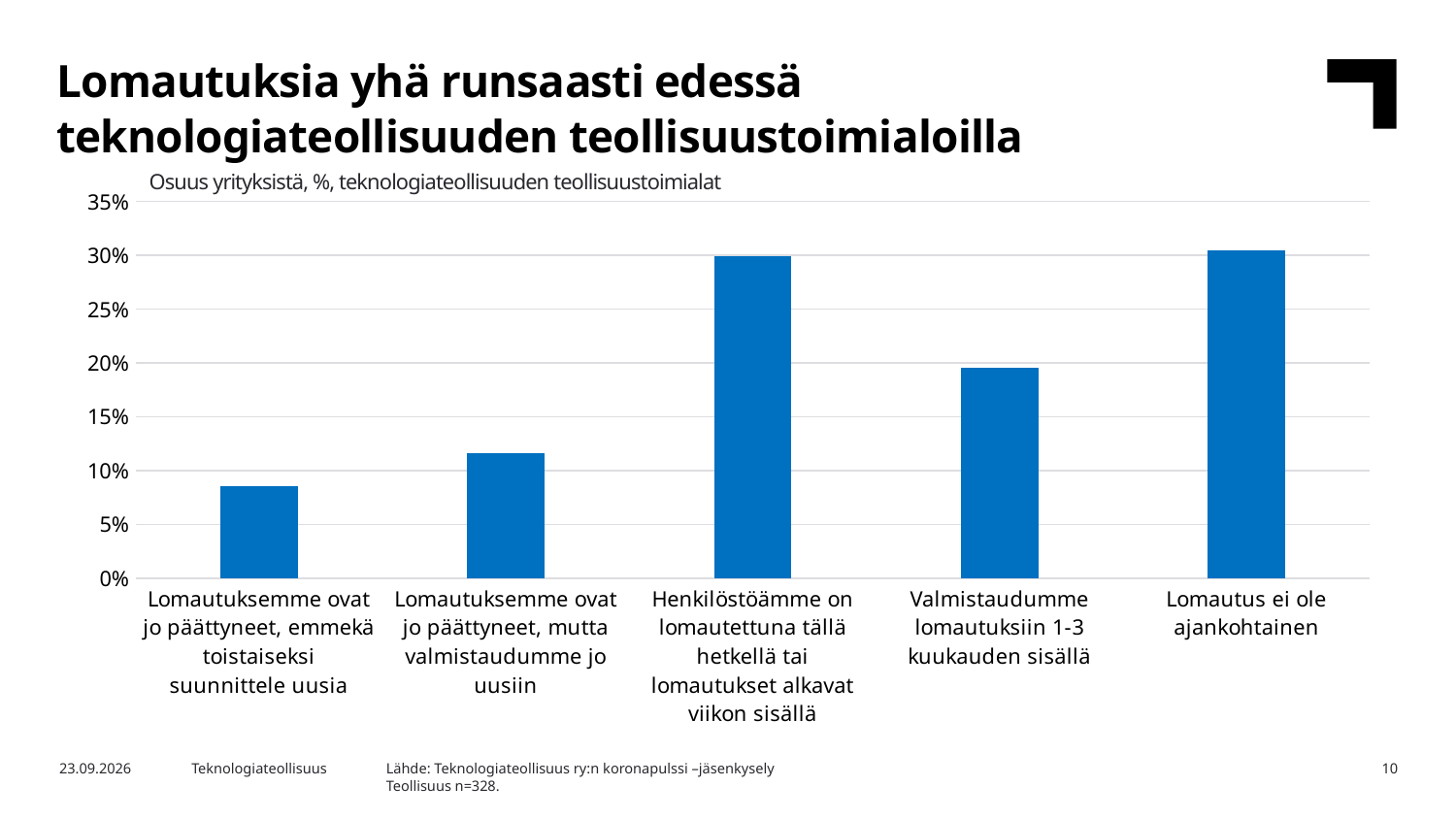
Is the value for "Lomautuksemme ovat jo päättyneet, mutta valmistaudumme jo uusiin" greater or less than 10%? greater Is the value for "Henkilöstöämme on lomautettuna tällä hetkellä tai lomautukset alkavat viikon sisällä" greater or less than 25%? greater What is the title printed above the chart? Osuus yrityksistä, %, teknologiateollisuuden teollisuustoimialat Is the value for "Lomautuksemme ovat jo päättyneet, emmekä toistaiseksi suunnittele uusia" greater or less than 10%? less What kind of chart is shown on the slide? Bar chart What is the maximum value shown on the chart's y axis? 35% Which is larger: the value for "Lomautuksemme ovat jo päättyneet, emmekä toistaiseksi suunnittele uusia" or the value for "Lomautuksemme ovat jo päättyneet, mutta valmistaudumme jo uusiin"? Lomautuksemme ovat jo päättyneet, mutta valmistaudumme jo uusiin How many categories are shown on the x axis of the chart? 5 Which category has the lowest value in the chart? Lomautuksemme ovat jo päättyneet, emmekä toistaiseksi suunnittele uusia Which is larger: the value for "Valmistaudumme lomautuksiin 1-3 kuukauden sisällä" or the value for "Henkilöstöämme on lomautettuna tällä hetkellä tai lomautukset alkavat viikon sisällä"? Henkilöstöämme on lomautettuna tällä hetkellä tai lomautukset alkavat viikon sisällä